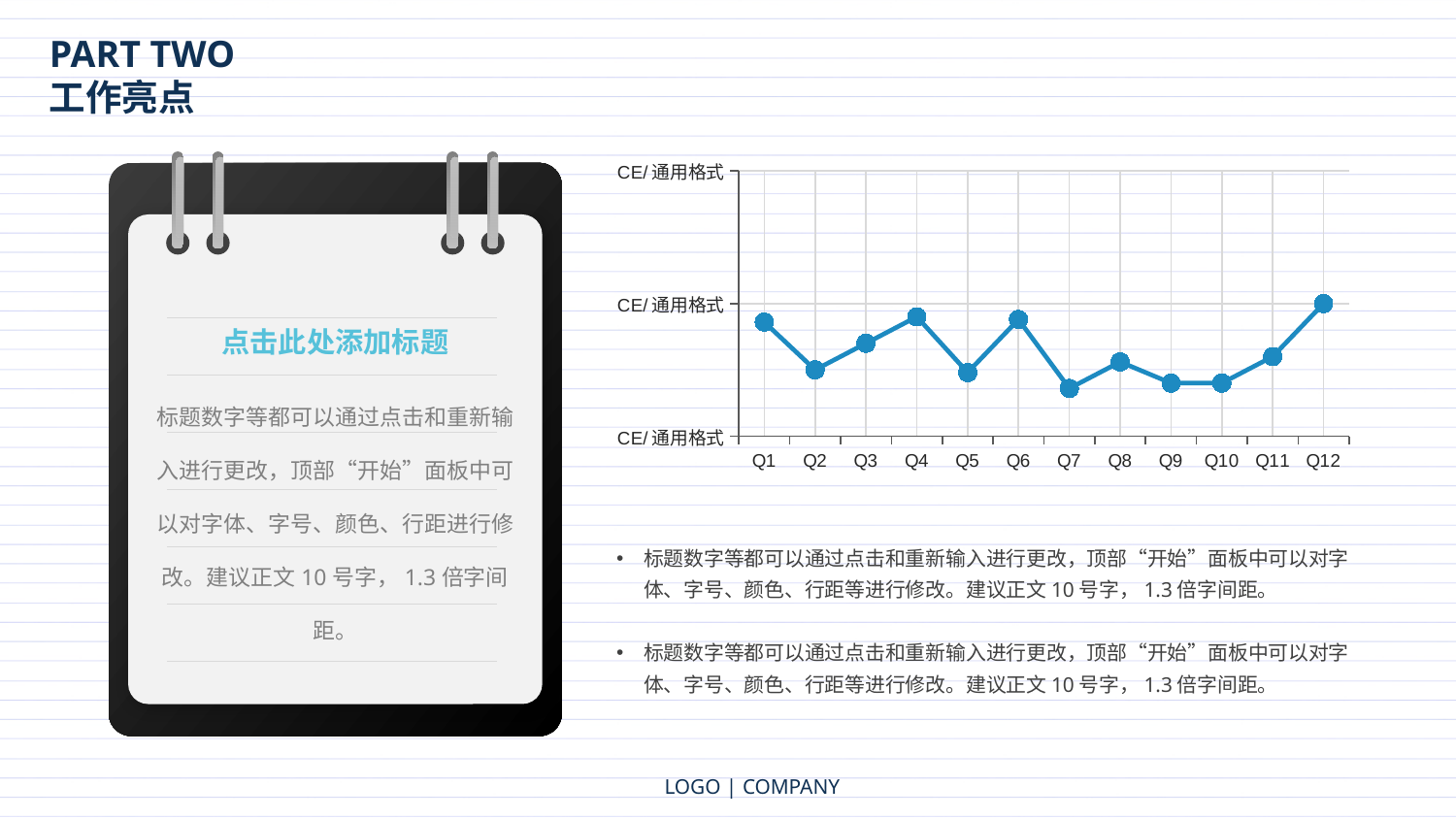
Do the values on the line chart rise or fall from Q6 to Q7? fall How many lines are plotted on the line chart? 1 Do the values on the line chart rise or fall from Q9 to Q12? rise Which is larger on the line chart, the value for Q12 or the value for Q1? Q12 What kind of chart is shown on the slide? line chart What is the label of the first category on the x axis of the line chart? Q1 Which is larger on the line chart, the value for Q6 or the value for Q7? Q6 How many data points are plotted on the line chart? 12 Which is larger on the line chart, the value for Q1 or the value for Q2? Q1 Which quarter has the highest value on the line chart? Q12